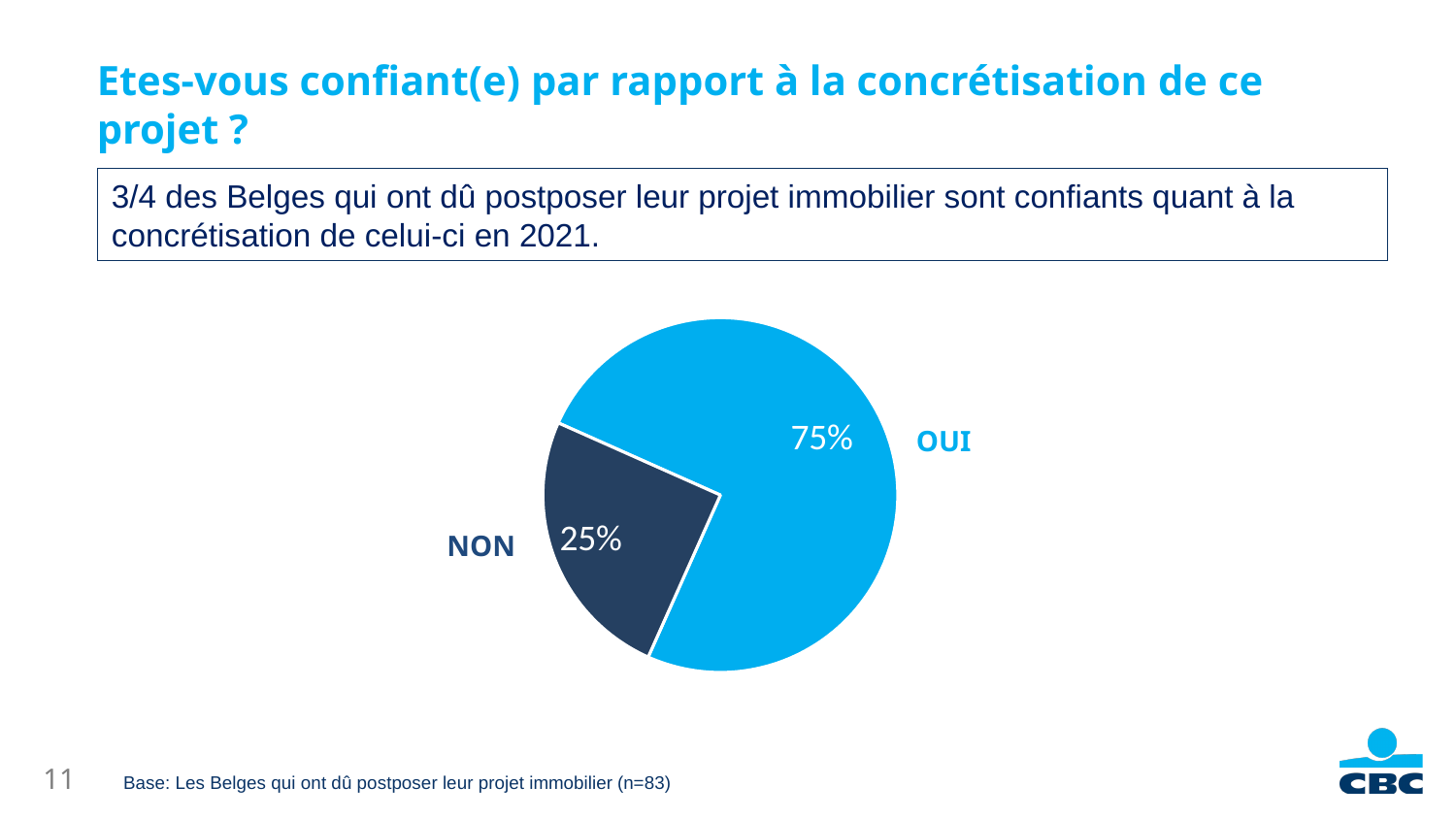
What is the sample size (n) stated in the base note below the chart? n=83 What kind of chart is shown on the slide? pie chart Which slice of the pie is the smallest? NON What is the difference in percentage points between the OUI and NON slices? 50 What percentage of respondents answered NON? 25% How many slices does the pie chart have? 2 What share of the pie does the OUI slice represent? 75% Which slice of the pie is the largest? OUI Which is larger, the OUI slice or the NON slice? OUI What colour is the NON slice of the pie? dark navy blue What share of the pie does the NON slice represent? 25% What percentage of respondents answered OUI? 75%